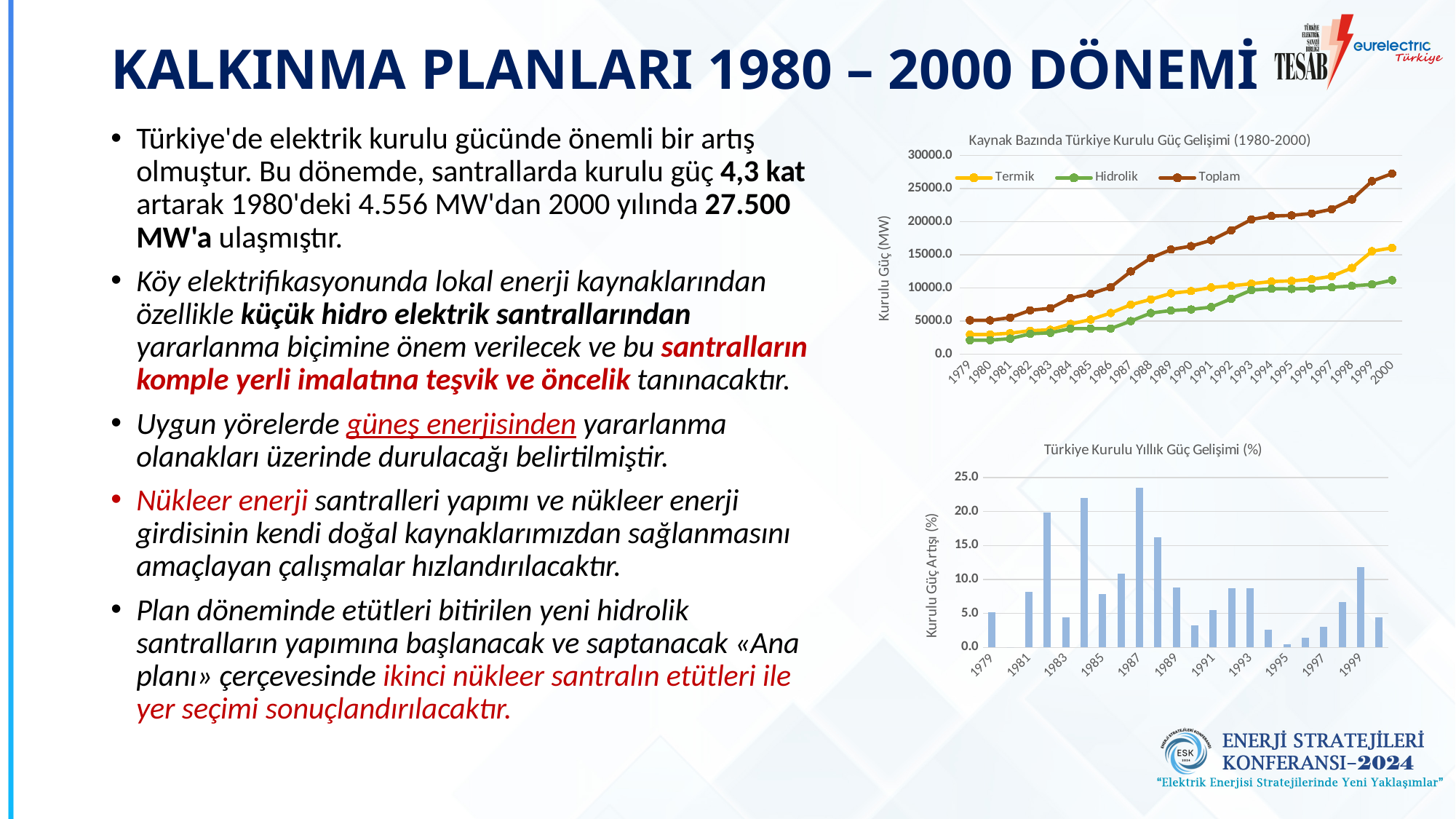
In the top chart, does the Toplam series rise or fall from 1979 to 2000? Rises In the top chart, what are the names of the series in the legend? Termik, Hidrolik, Toplam In the top chart, how many years are shown on the x axis? 22 In the bottom chart, is the value for 1987 greater or less than 20.0? greater In the top chart, which series has the higher value in 2000, Termik or Hidrolik? Termik In the top chart, is the value of Toplam in 2000 greater or less than 25000? greater In the top chart, how many series does the legend list? 3 What kind of chart is the bottom chart titled 'Türkiye Kurulu Yıllık Güç Gelişimi (%)'? Bar chart In the top chart, is the value of Hidrolik in 2000 greater or less than 10000? greater In the bottom chart, which year has the highest annual growth percentage? 1987 What kind of chart is the top chart titled 'Kaynak Bazında Türkiye Kurulu Güç Gelişimi (1980-2000)'? Line chart